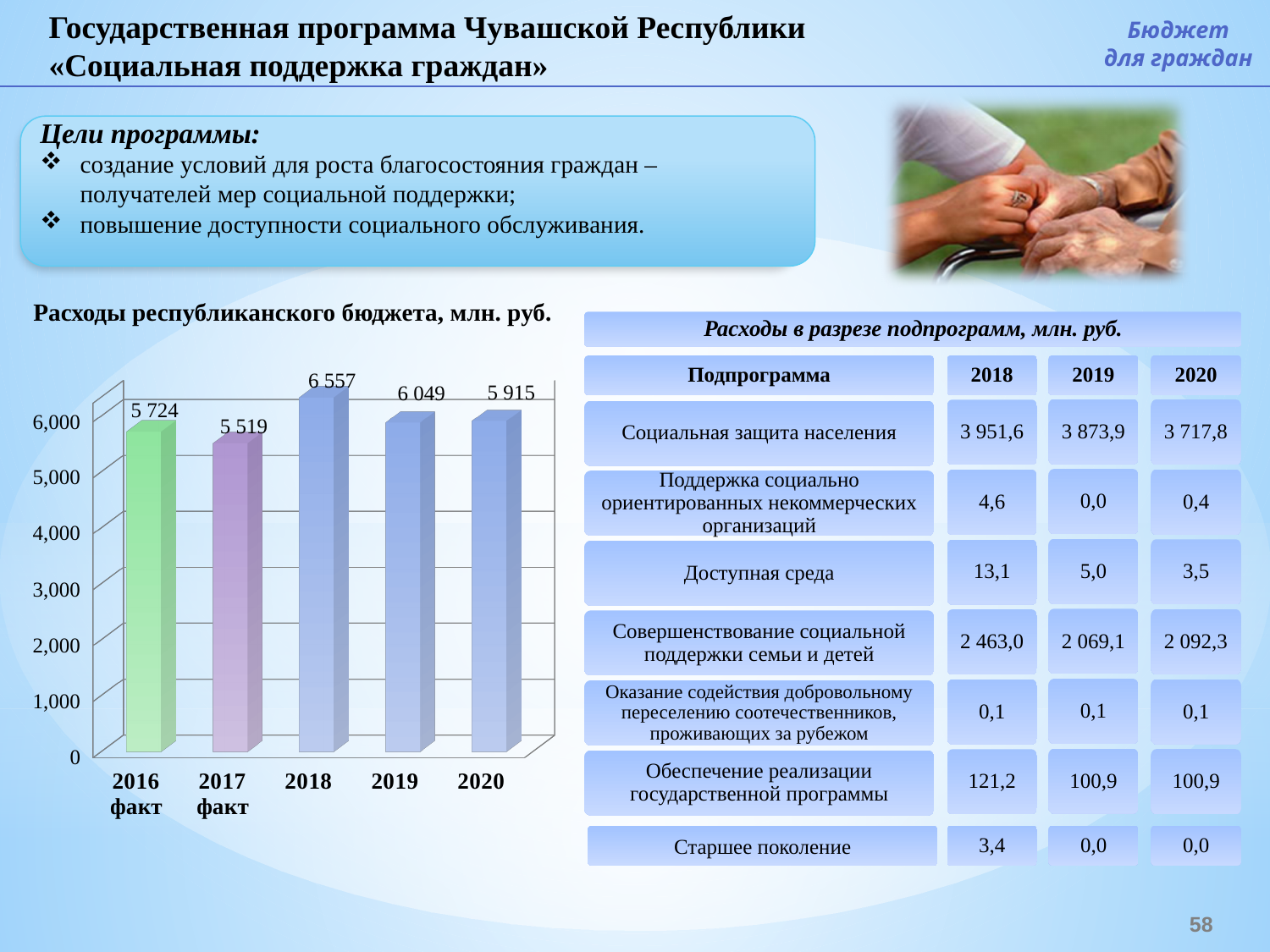
Which year has the highest value in the chart 'Расходы республиканского бюджета, млн. руб.'? 2018 How many bars are shown in the chart 'Расходы республиканского бюджета, млн. руб.'? 5 What type of chart is 'Расходы республиканского бюджета, млн. руб.'? bar chart In the chart 'Расходы республиканского бюджета, млн. руб.', which is larger: the value for 2016 факт or the value for 2020? 2020 In the chart 'Расходы республиканского бюджета, млн. руб.', do the values rise or fall from 2018 to 2020? fall What is the value for 2017 факт in the chart 'Расходы республиканского бюджета, млн. руб.'? 5 519 What is the value for 2020 in the chart 'Расходы республиканского бюджета, млн. руб.'? 5 915 What is the difference between the 2018 and 2019 values in the chart 'Расходы республиканского бюджета, млн. руб.'? 508 What is the value for 2018 in the chart 'Расходы республиканского бюджета, млн. руб.'? 6 557 What is the difference between the 2016 факт and 2017 факт values in the chart 'Расходы республиканского бюджета, млн. руб.'? 205 Which year has the lowest value in the chart 'Расходы республиканского бюджета, млн. руб.'? 2017 факт In the chart 'Расходы республиканского бюджета, млн. руб.', is the value for 2017 факт greater or less than 6,000? less